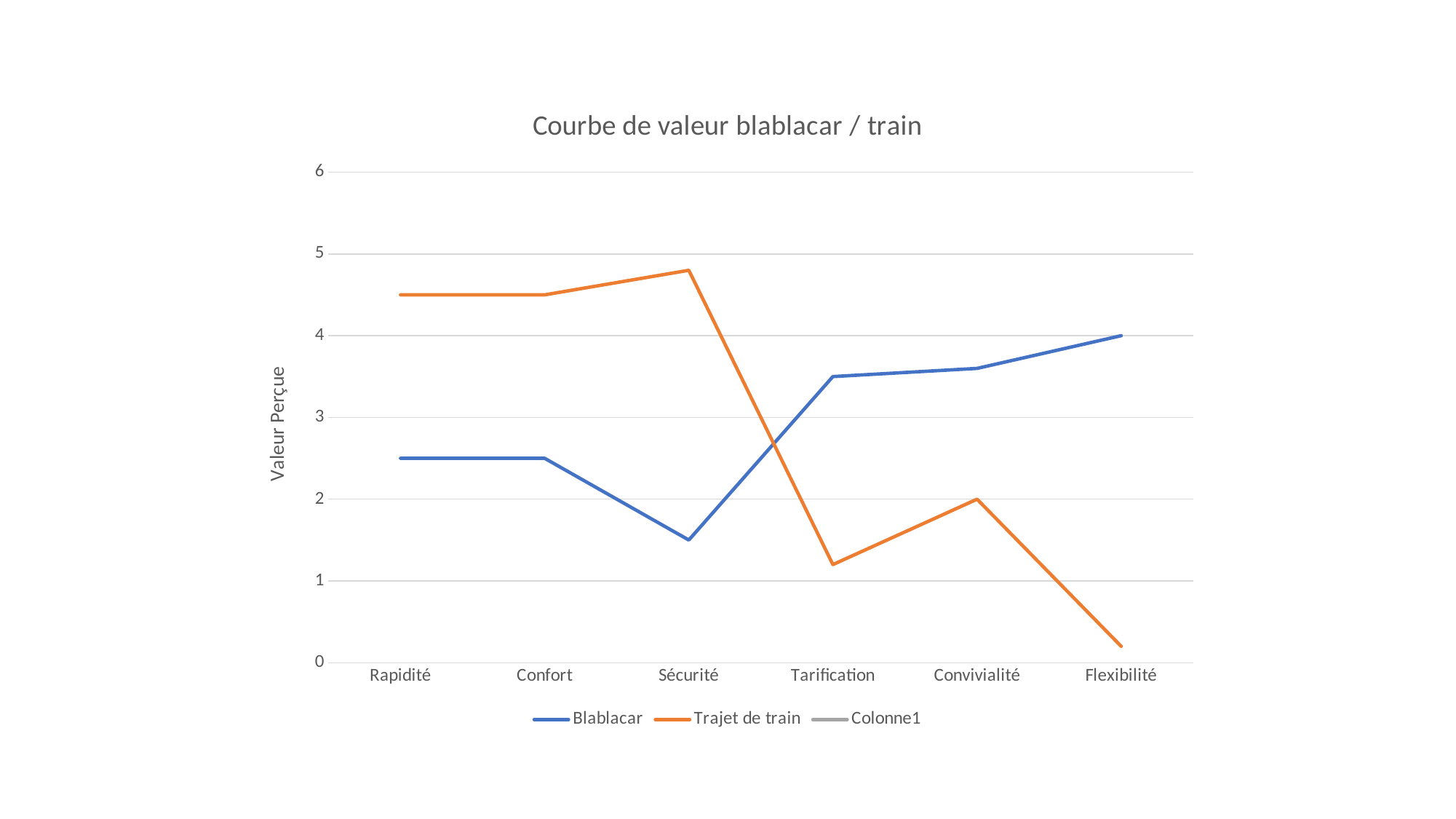
At Rapidité, which series has the higher value, Blablacar or Trajet de train? Trajet de train For which category is the Blablacar value highest? Flexibilité How many categories are shown on the x axis? 6 For which category is the Blablacar value lowest? Sécurité How many series does the legend list? 3 What is the value for Blablacar at Flexibilité? 4 What kind of chart is shown on the slide? line chart What is the value for Trajet de train at Convivialité? 2 What is the label of the y axis? Valeur Perçue For which category is the Trajet de train value highest? Sécurité For which category is the Trajet de train value lowest? Flexibilité Is the value for Trajet de train at Tarification greater or less than 2? less